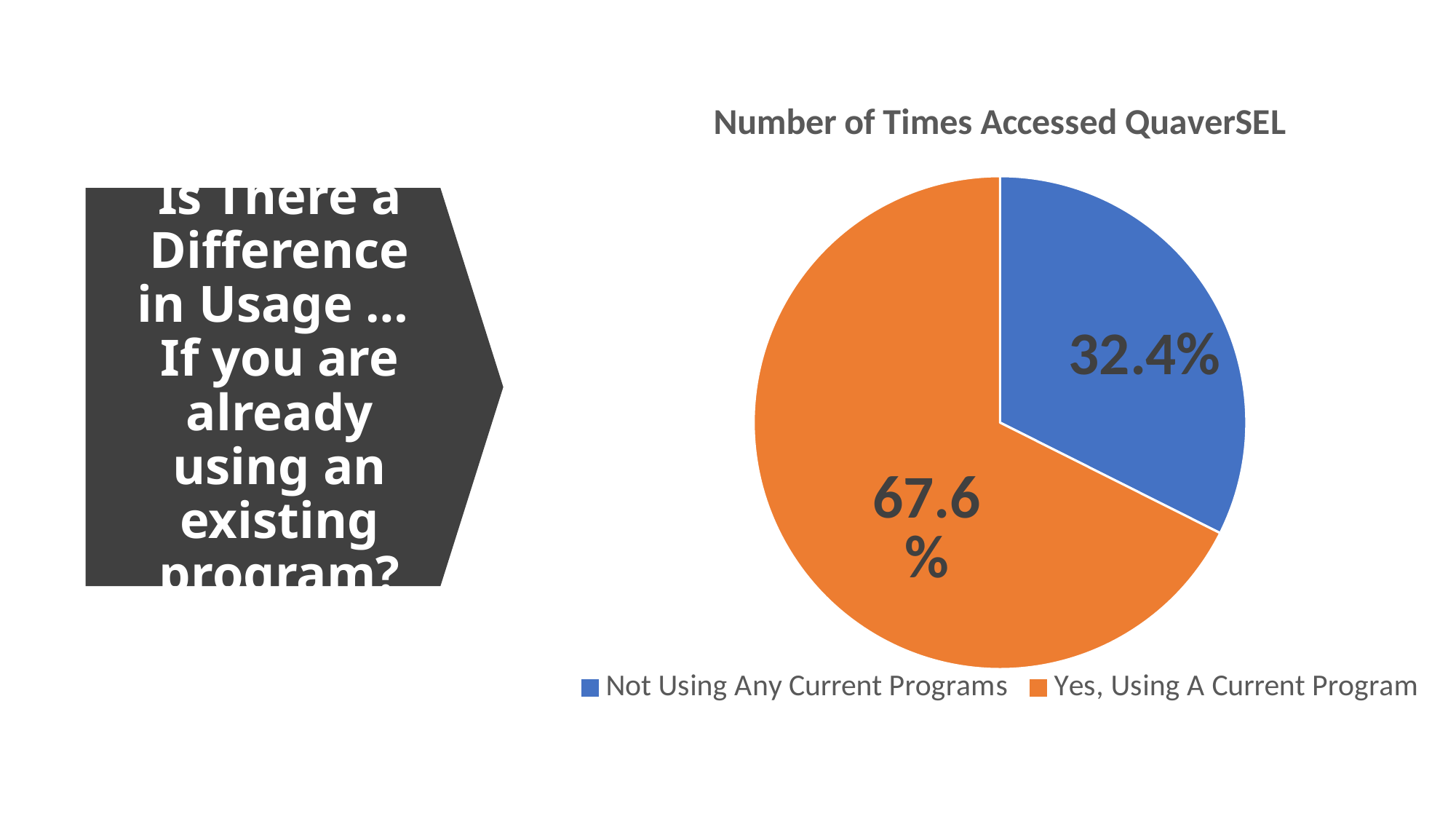
Which slice of the pie is the smallest? Not Using Any Current Programs How many slices does the pie chart have? 2 What share of the pie is labelled "Yes, Using A Current Program"? 67.6% How many entries does the legend list? 2 What share of the pie is labelled "Not Using Any Current Programs"? 32.4% What type of chart is shown on the slide? pie chart What is the title of the chart? Number of Times Accessed QuaverSEL What colour is the slice for "Not Using Any Current Programs"? blue Which is larger: the slice for "Not Using Any Current Programs" or the slice for "Yes, Using A Current Program"? Yes, Using A Current Program What is the difference in percentage points between the "Yes, Using A Current Program" slice and the "Not Using Any Current Programs" slice? 35.2 percentage points Which slice of the pie is the largest? Yes, Using A Current Program